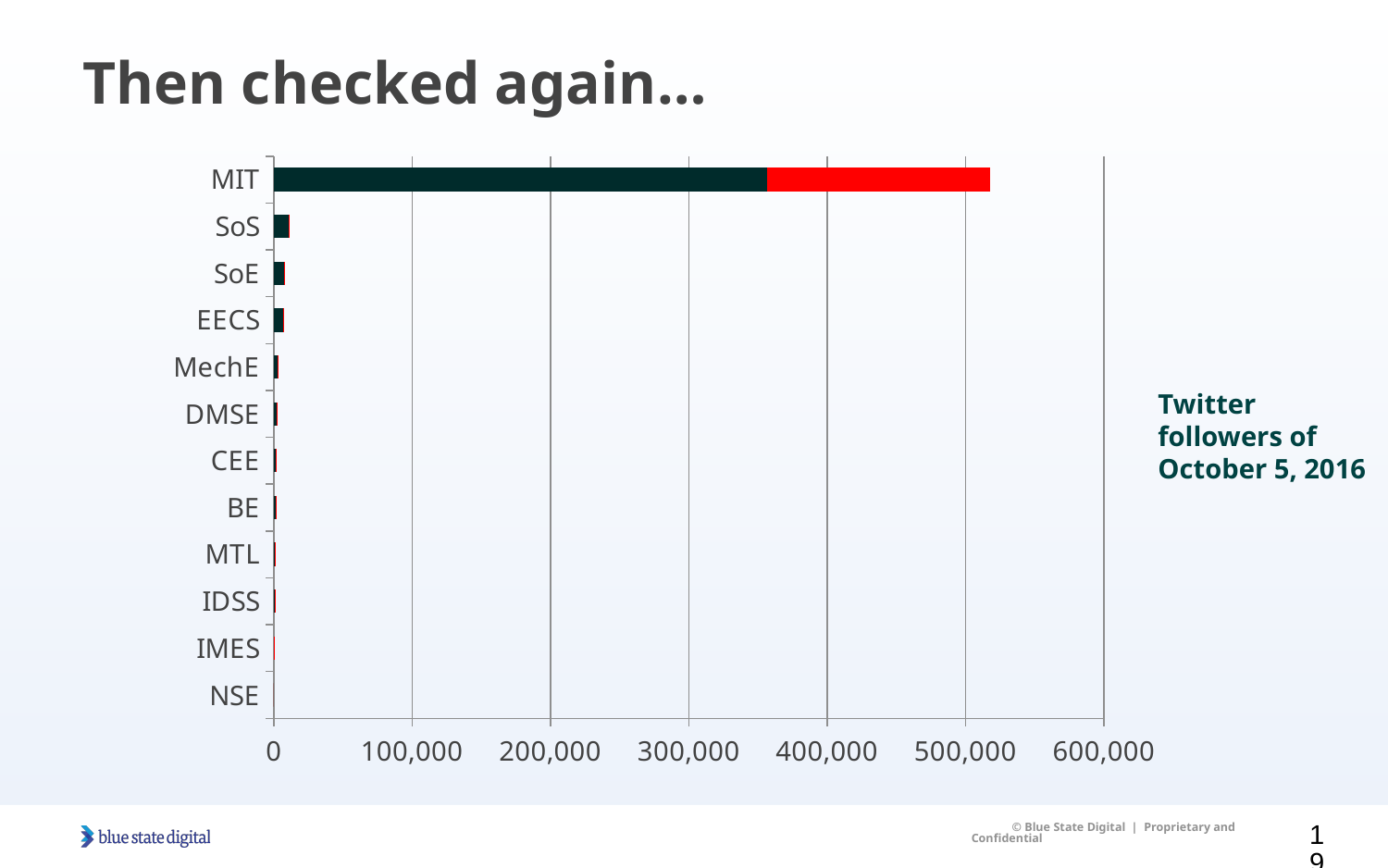
Is the value for SoS greater or less than 100,000? less How many categories are shown on the chart's vertical axis? 12 Is the dark green segment of the MIT bar greater or less than 300,000? greater According to the text beside the chart, what do the bars represent? Twitter followers of October 5, 2016 Which has a larger value, SoS or MechE? SoS What is the title of the slide containing the chart? Then checked again... Which has a larger value, MIT or EECS? MIT Is the total value for MIT greater or less than 500,000? greater Which category has the highest value on the chart? MIT What kind of chart is shown on the slide? bar chart